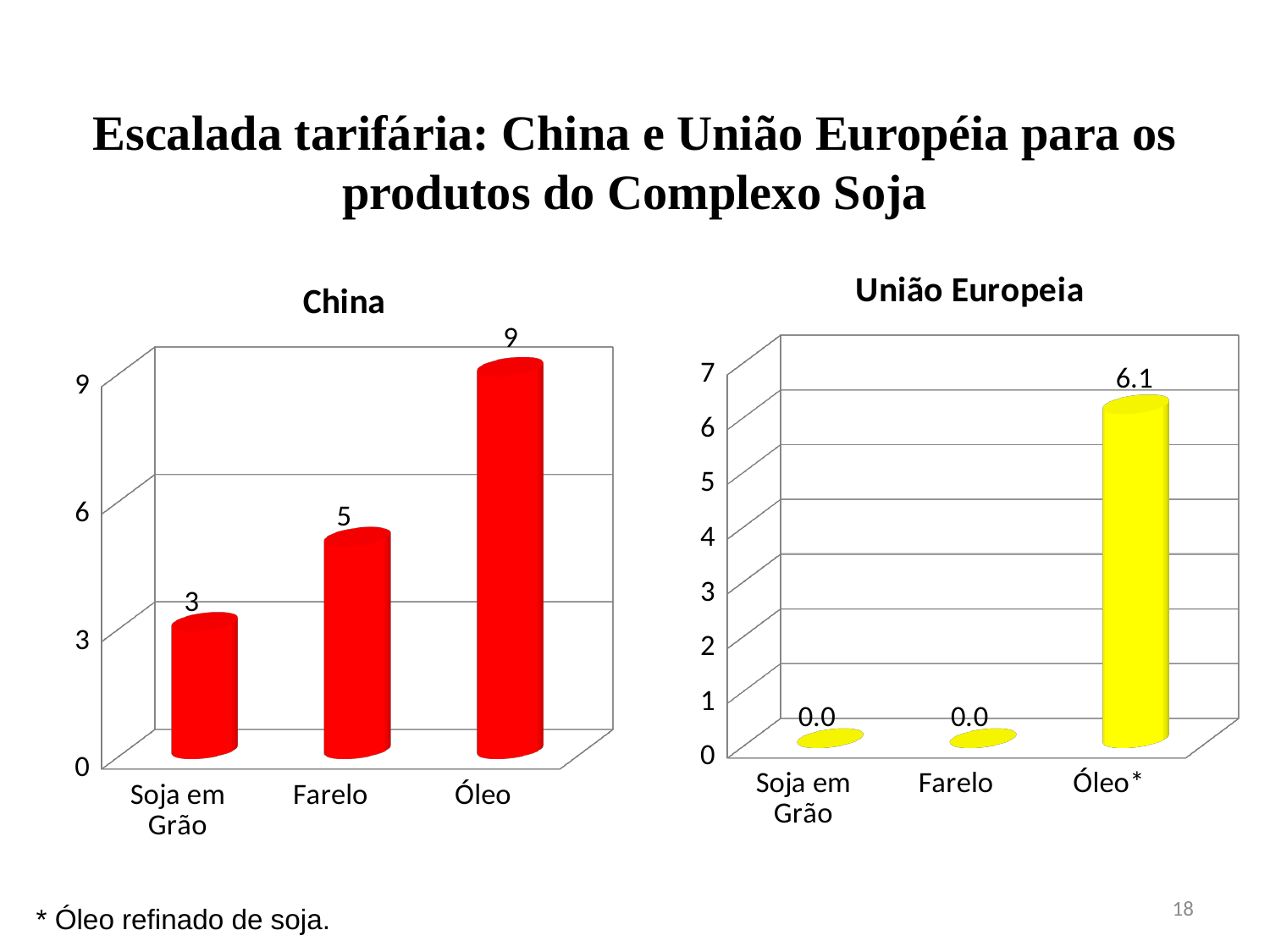
What kind of chart is the China chart? bar chart In the União Europeia chart, what is the value for Soja em Grão? 0.0 In the China chart, what is the difference between the values for Óleo and Soja em Grão? 6 In the China chart, what is the value for Farelo? 5 How many categories does the União Europeia chart show? 3 In the China chart, which category has the highest value? Óleo In the China chart, which is larger, the value for Farelo or the value for Soja em Grão? Farelo In the China chart, do the values rise or fall from Soja em Grão to Óleo? rise In the China chart, which category has the lowest value? Soja em Grão In the União Europeia chart, what is the value for Óleo*? 6.1 In the China chart, what is the value for Óleo? 9 In the União Europeia chart, which category has the highest value? Óleo*